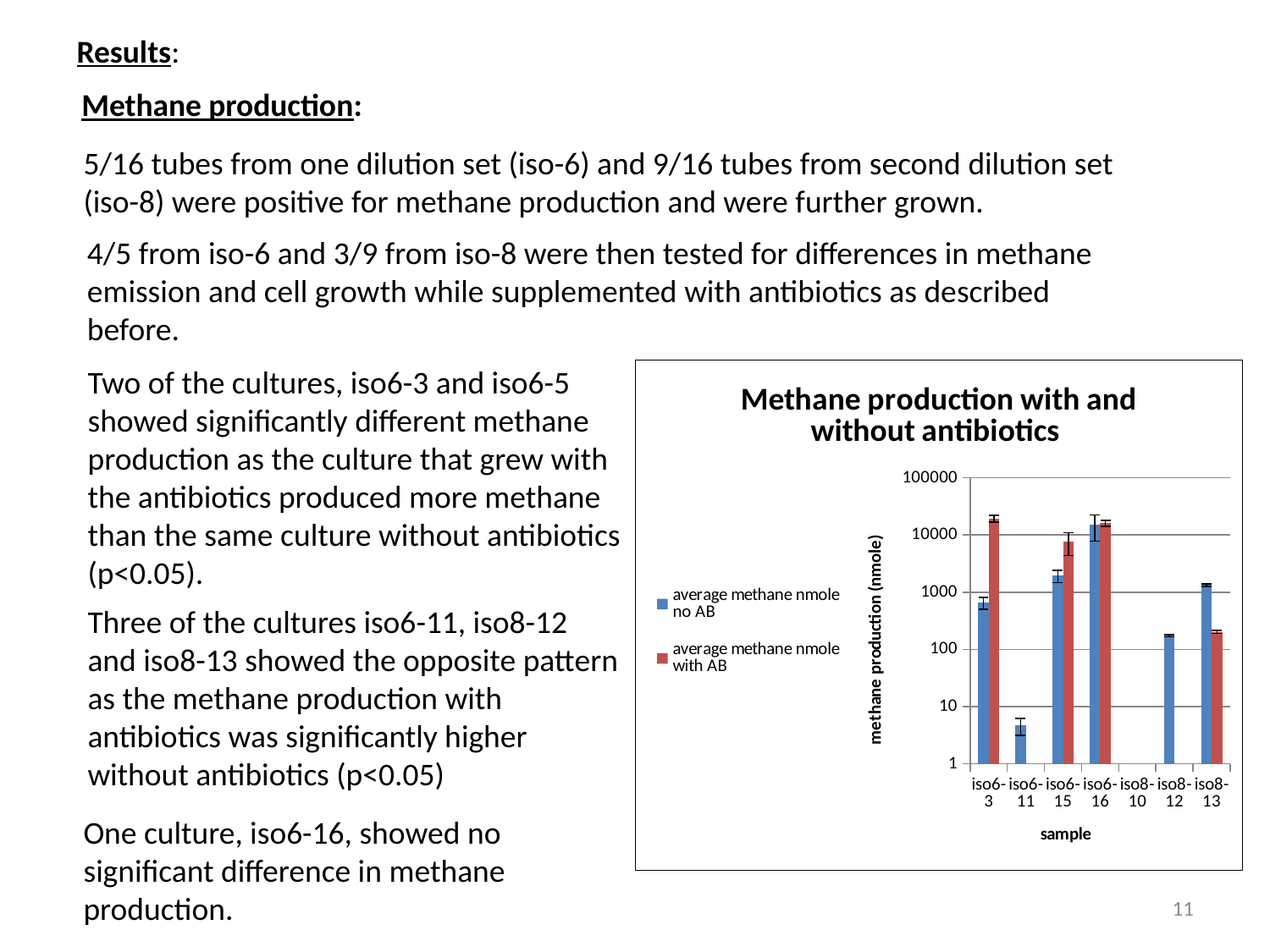
What is the title of the chart? Methane production with and without antibiotics Is the 'average methane nmole no AB' value for iso6-11 greater or less than 10? less For iso6-3, which is larger: the 'average methane nmole no AB' value or the 'average methane nmole with AB' value? average methane nmole with AB What kind of chart is shown on the slide? bar chart Is the 'average methane nmole with AB' value for iso6-3 greater or less than 10000? greater How many series does the chart legend list? 2 Is the 'average methane nmole no AB' value for iso8-13 greater or less than 1000? greater How many sample categories are shown on the x axis of the chart? 7 What is the label of the y axis of the chart? methane production (nmole) For iso8-13, which is larger: the 'average methane nmole no AB' value or the 'average methane nmole with AB' value? average methane nmole no AB